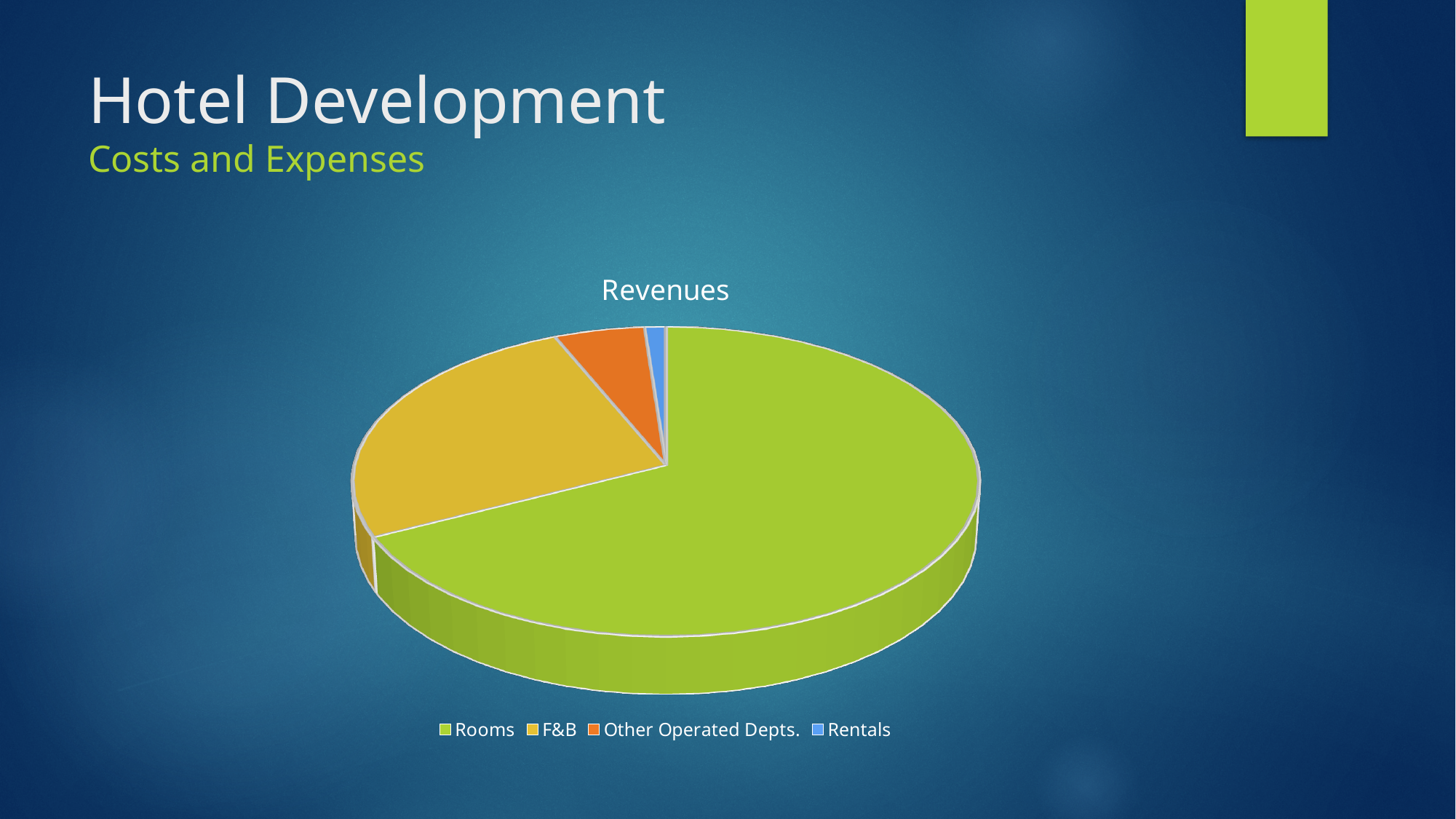
Which slice is larger, F&B or Other Operated Depts.? F&B Does the Rooms slice account for more or less than half of the pie? more Which slice is larger, Other Operated Depts. or Rentals? Other Operated Depts. Which category is shown in green in the pie chart? Rooms Which slice is larger, Rooms or F&B? Rooms Which category has the smallest slice of the pie? Rentals What is the title of the chart? Revenues How many categories does the pie chart show? 4 Which category has the largest slice of the pie? Rooms What kind of chart is shown on the slide? pie chart